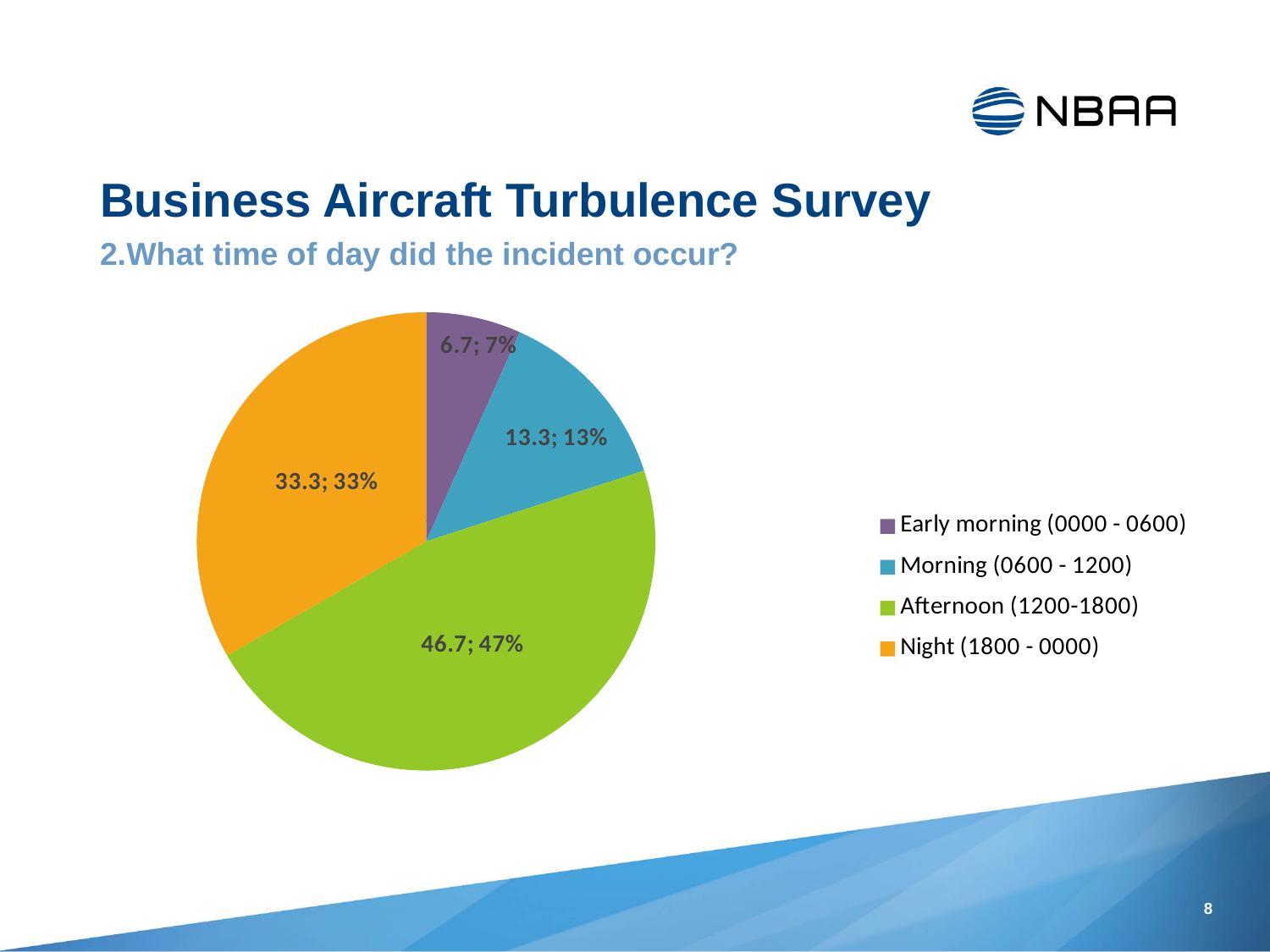
How many categories does the pie chart have? 4 Which time of day has the smallest slice? Early morning (0000 - 0600) What kind of chart is shown on the slide? pie chart What percentage share of the pie does Night (1800 - 0000) represent? 33% What value is shown for Morning (0600 - 1200)? 13.3; 13% What value is shown for Early morning (0000 - 0600)? 6.7; 7% What colour is the Afternoon (1200-1800) slice? green Which is larger, the Morning (0600 - 1200) slice or the Night (1800 - 0000) slice? Night (1800 - 0000) What value is shown for Night (1800 - 0000)? 33.3; 33% What value is shown for Afternoon (1200-1800)? 46.7; 47% What is the difference between the Afternoon (1200-1800) value and the Night (1800 - 0000) value? 13.4 Which time of day has the largest slice? Afternoon (1200-1800)